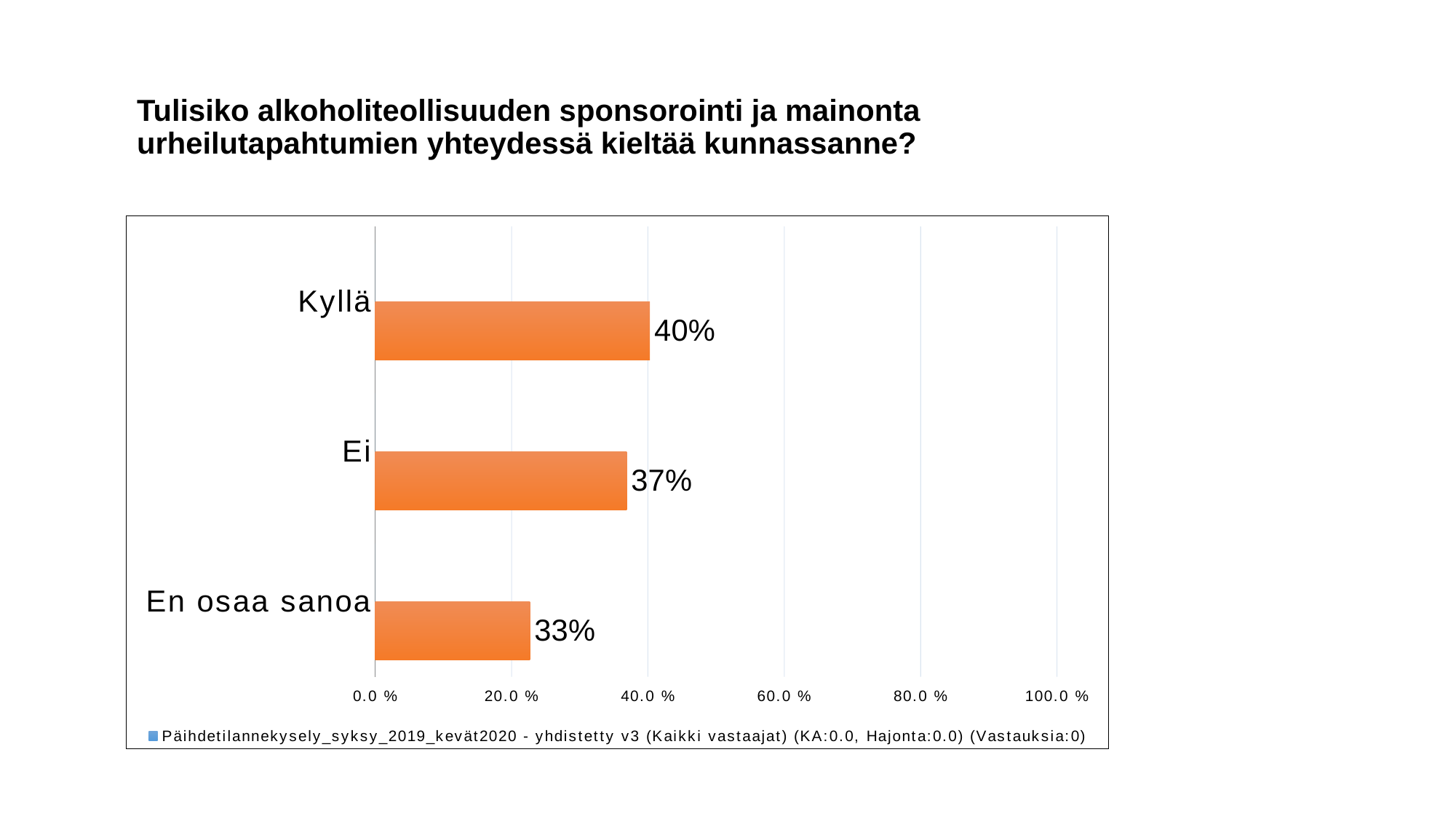
Which category has the lowest value? En osaa sanoa Which category has the highest value? Kyllä Is the value for En osaa sanoa greater or less than 40.0 %? less What is the highest value shown on the x axis? 100.0 % How many categories are shown in the chart? 3 Which is larger, the value for Ei or the value for En osaa sanoa? Ei What kind of chart is shown on the slide? bar chart What is the value for En osaa sanoa? 33% What is the value for Kyllä? 40% What is the difference between the values for Kyllä and En osaa sanoa? 7% What is the value for Ei? 37% What is the difference between the values for Kyllä and Ei? 3%